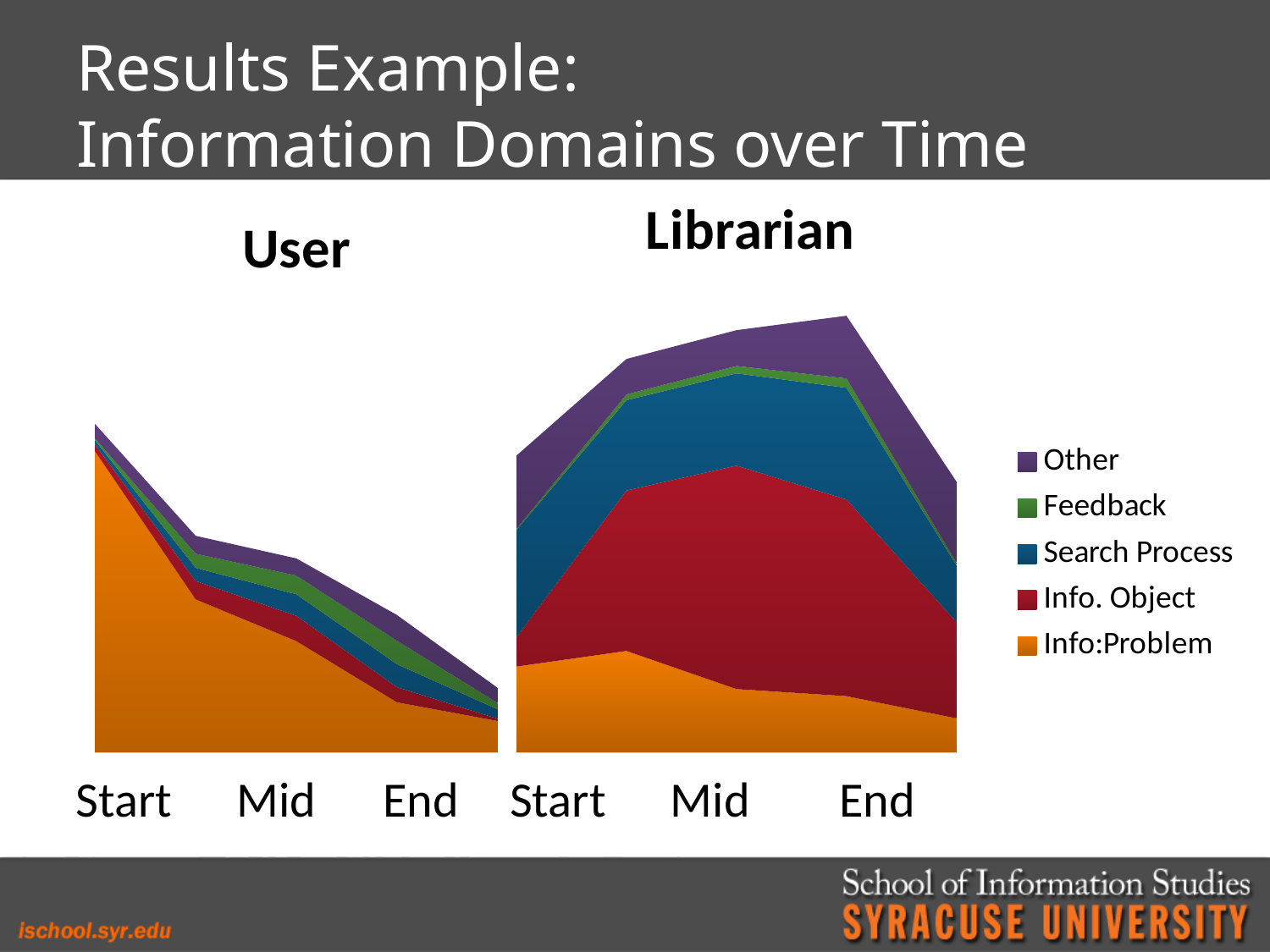
How many series does the legend list? 5 At End, which chart has the larger total stacked value, User or Librarian? Librarian In the Librarian chart, which series is the largest at Mid? Info. Object In the User chart, does the total stacked value rise or fall from Start to End? fall In the User chart, which series is the largest at Start? Info:Problem In the Librarian chart, does the total stacked value rise or fall from Start to Mid? rise What colour represents the Other series in the legend? purple In the User chart, does the Info:Problem series rise or fall from Start to End? fall What kind of chart is the User chart? stacked area chart Which series is shown at the bottom of the stack in both charts? Info:Problem How many time points are shown on the x axis of the Librarian chart? 3 In the Librarian chart, is the Info. Object value larger at Start or at Mid? Mid